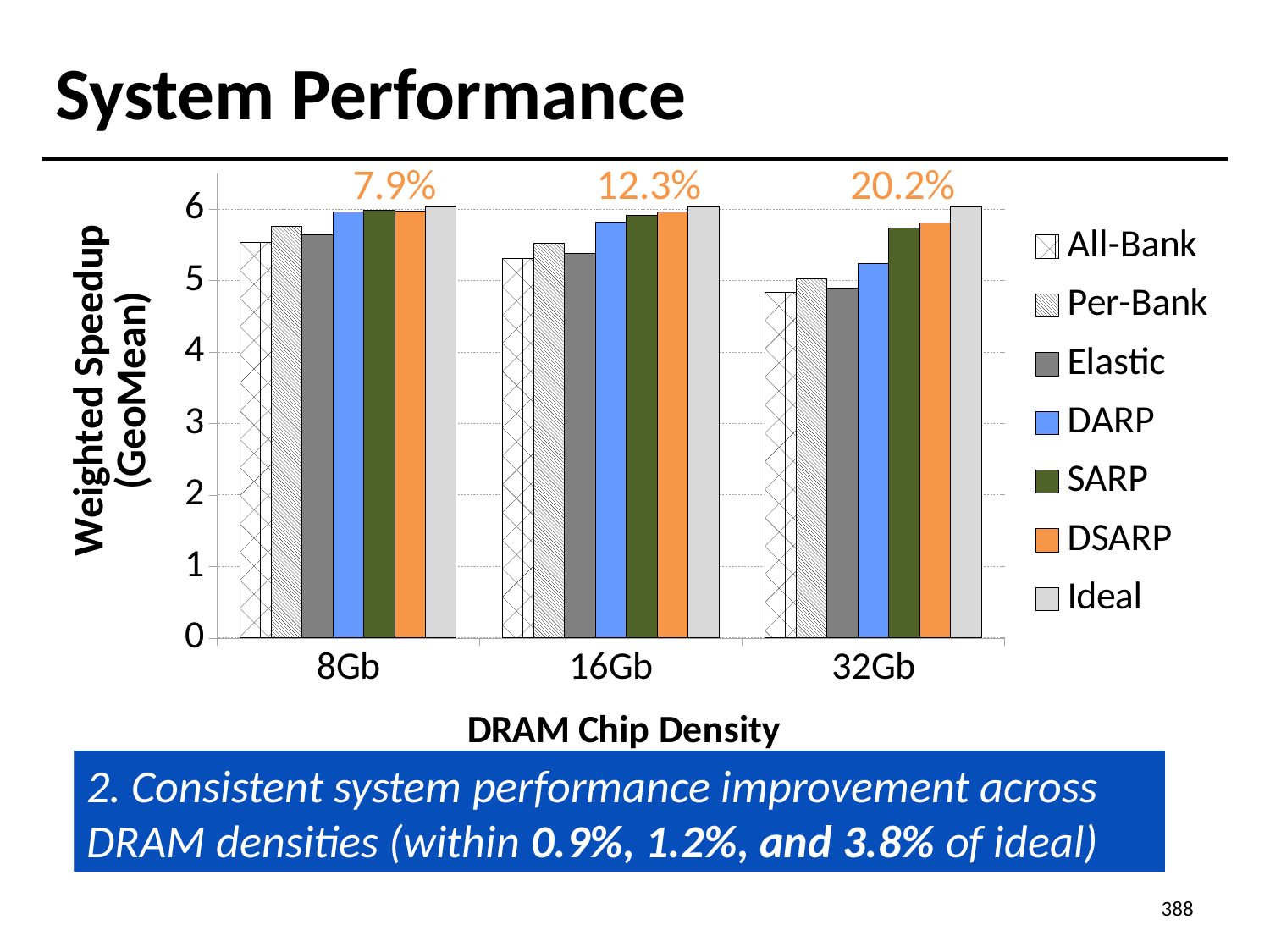
Does the All-Bank value rise or fall as DRAM chip density increases from 8Gb to 32Gb? fall How many series does the legend list? 7 What is the title of the x axis? DRAM Chip Density Is the value for All-Bank at 8Gb greater or less than 5? greater Is the value for All-Bank at 32Gb greater or less than 5? less How many DRAM chip density categories are shown on the x axis? 3 Is the value for DARP at 32Gb greater or less than 5? greater What percentage is printed above the 32Gb group of bars? 20.2% Which series has the lowest value at 32Gb? All-Bank What kind of chart is shown on the slide? bar chart At 32Gb, which is larger, DSARP or Elastic? DSARP Which series has the highest value at 32Gb? Ideal